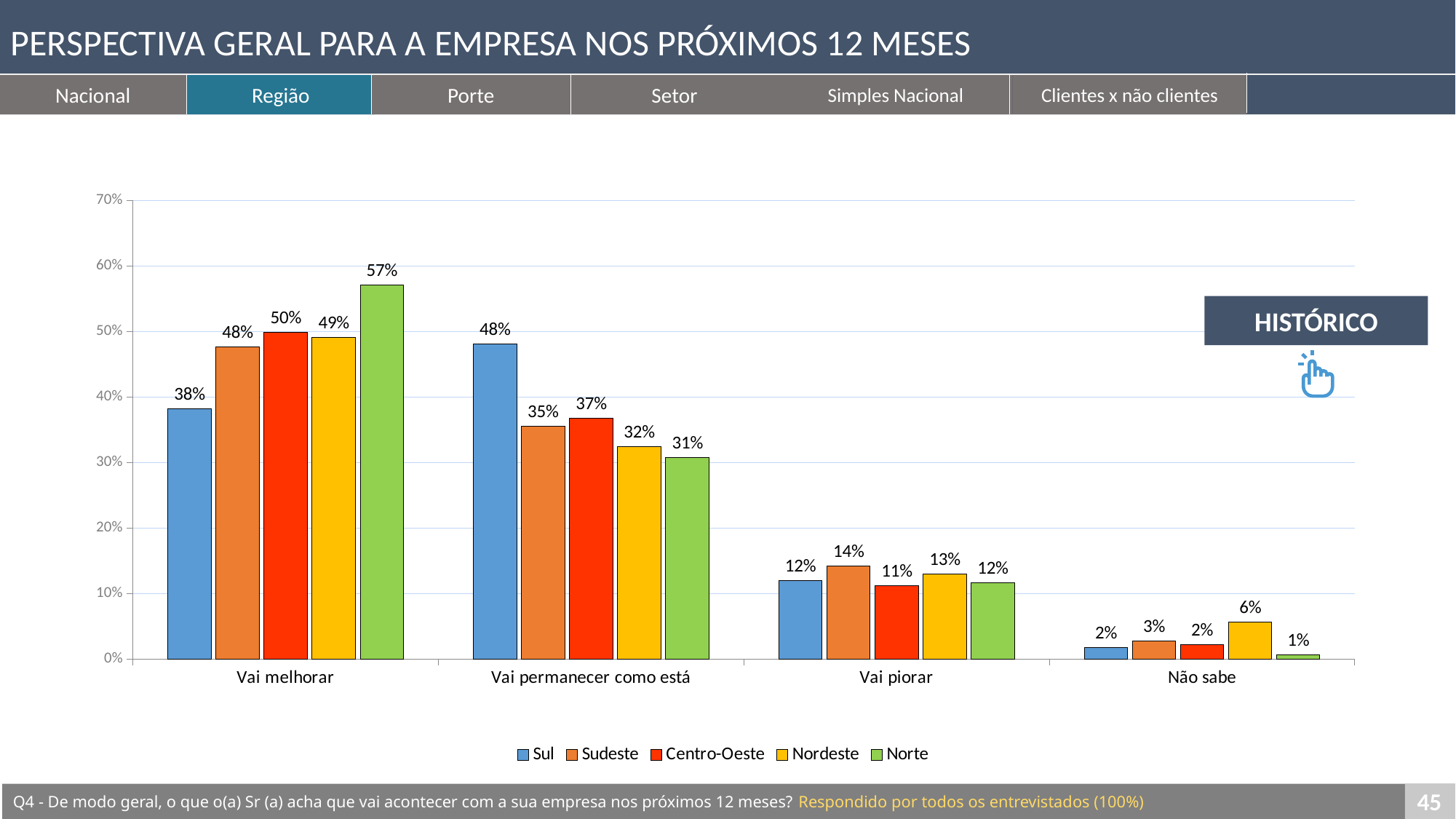
How many series does the legend list? 5 What is the difference between the Norte and Sul values in the 'Vai melhorar' category? 19% What kind of chart is shown on the slide? Bar chart What is the value for Nordeste in the 'Não sabe' category? 6% Which region has the highest value in the 'Vai melhorar' category? Norte What is the value for Sul in the 'Vai permanecer como está' category? 48% Which colour represents the Norte series in the legend? Green What is the value for Norte in the 'Vai melhorar' category? 57% How many categories are shown on the x axis? 4 Is the value for Sul in 'Vai melhorar' greater or less than 40%? less Which region has the lowest value in the 'Vai piorar' category? Centro-Oeste In the 'Vai permanecer como está' category, which is larger: Sudeste or Centro-Oeste? Centro-Oeste